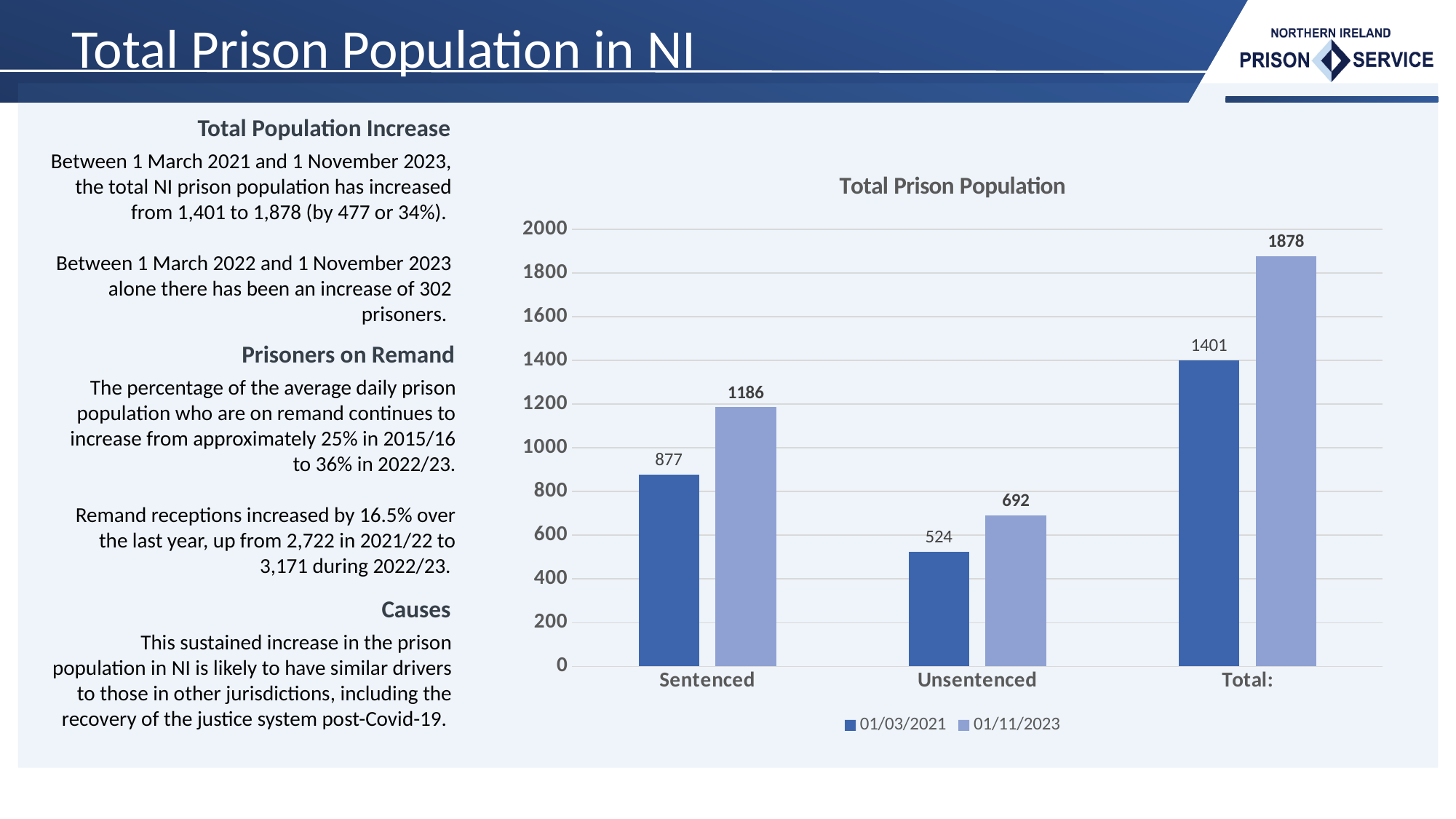
What is the value for Sentenced on 01/03/2021? 877 Which category has the lowest value for the 01/03/2021 series? Unsentenced What is the value for Unsentenced on 01/03/2021? 524 How many categories are shown on the x axis? 3 What is the difference between the Sentenced values for 01/11/2023 and 01/03/2021? 309 Which category has the highest value for the 01/11/2023 series? Total: What is the Total value on 01/11/2023? 1878 Which is larger: Sentenced on 01/11/2023 or Total on 01/03/2021? Total on 01/03/2021 What is the value for Unsentenced on 01/11/2023? 692 How many series does the legend list? 2 What kind of chart is shown on the slide? Bar chart What is the difference between the Total values for 01/11/2023 and 01/03/2021? 477